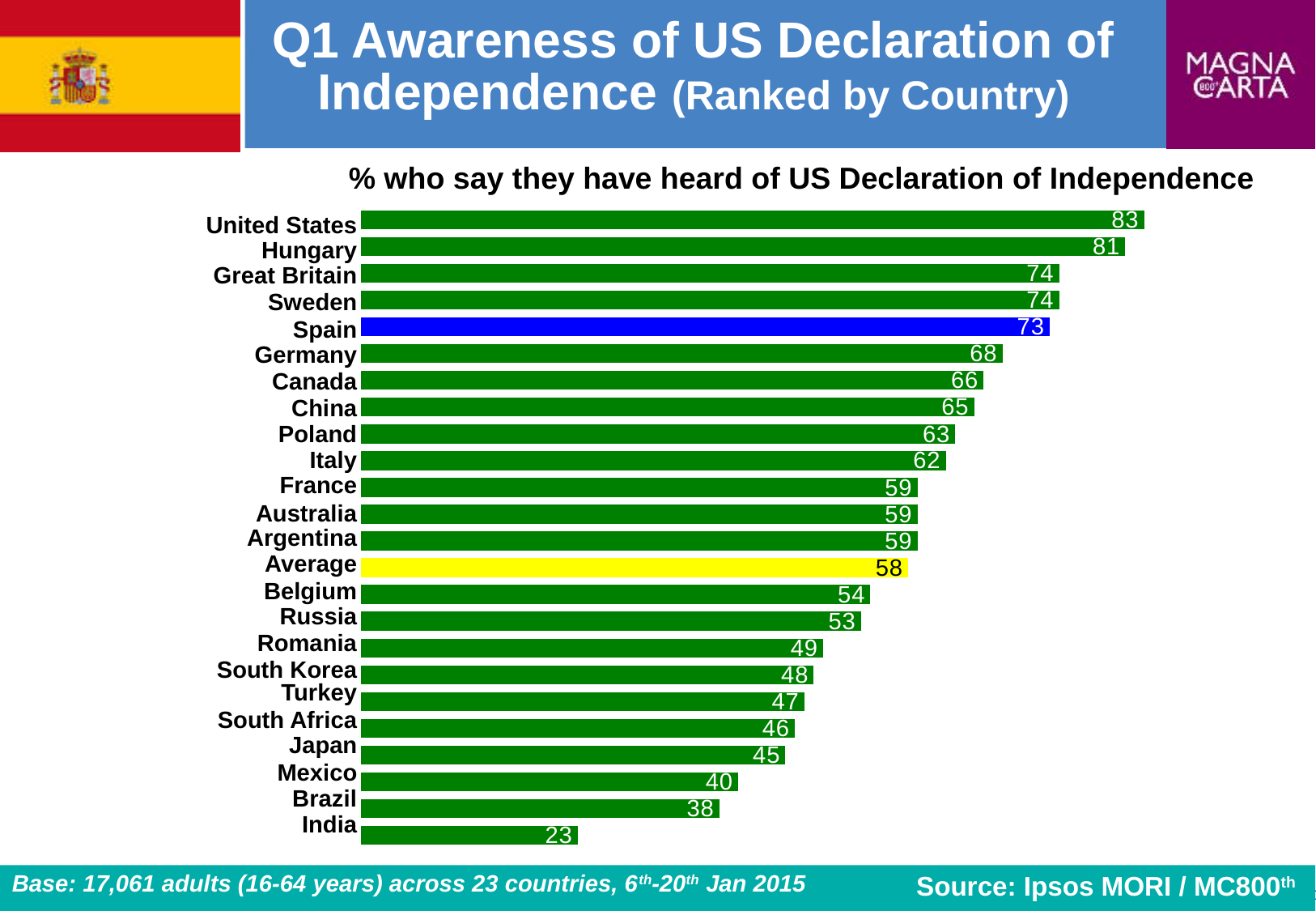
What kind of chart is shown on the slide? Bar chart What is the difference between the values for the United States and India? 60 How many bars are plotted in the chart, including the Average? 24 Which has a larger value, Canada or Poland? Canada Which country has the highest value? United States What is the value for Spain? 73 Which has a larger value, Brazil or Mexico? Mexico Which country has the lowest value? India What colour is the bar for Spain? Blue What is the value for Germany? 68 What is the difference between the values for Spain and the Average? 15 What is the value shown for the Average bar? 58